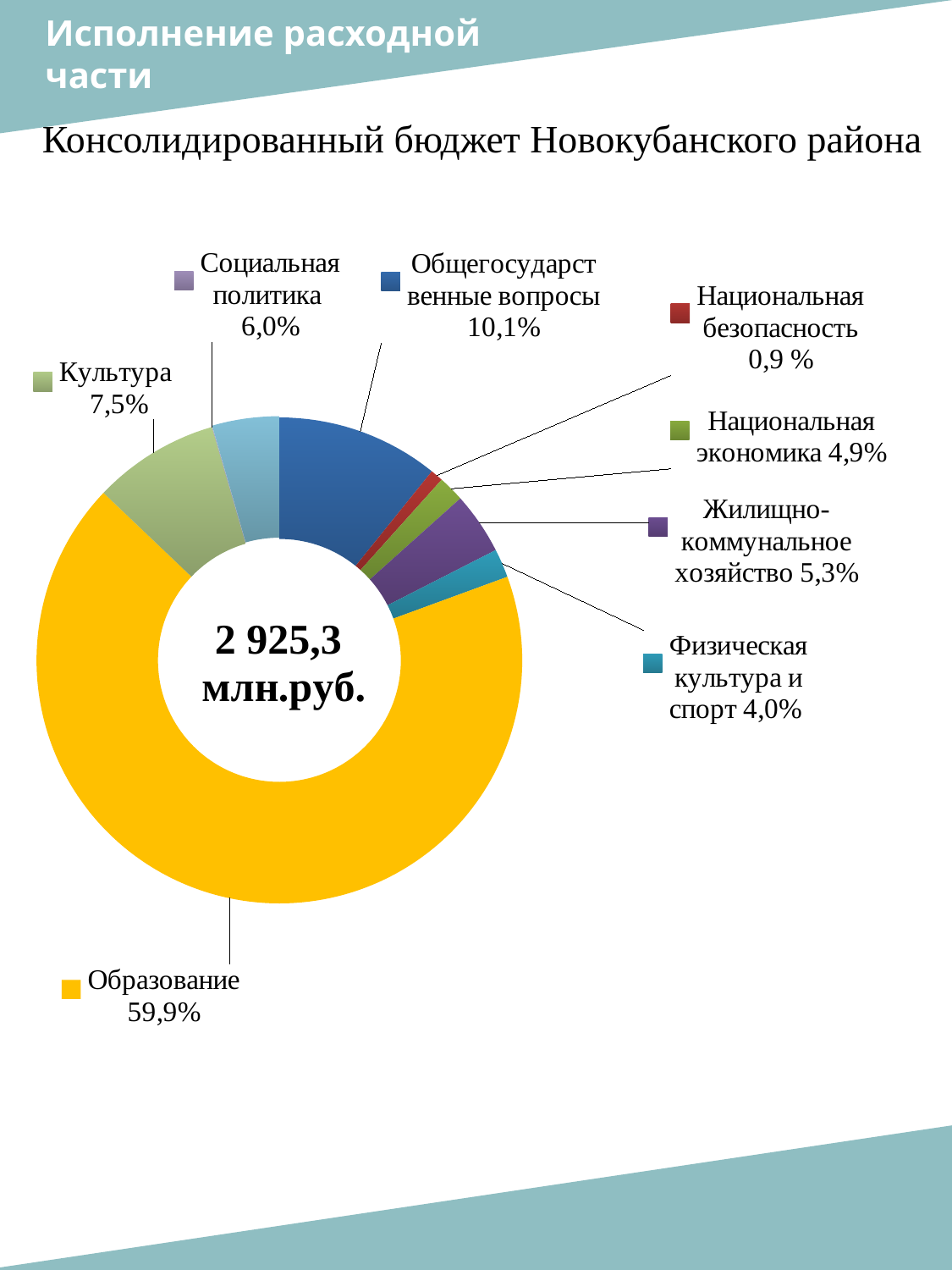
What is the difference in percentage points between Культура and Социальная политика? 1,5 Which has a larger share: Национальная экономика or Физическая культура и спорт? Национальная экономика Which category has the smallest share of the budget? Национальная безопасность What share is shown for Общегосударственные вопросы? 10,1% What share is shown for Жилищно-коммунальное хозяйство? 5,3% How many categories are shown in the chart? 8 What share of the consolidated budget goes to Образование? 59,9% What kind of chart is shown on the slide? Pie (doughnut) chart What is the title of the chart? Консолидированный бюджет Новокубанского района Which category has the largest share of the budget? Образование What share is shown for Национальная безопасность? 0,9 % What total amount is printed in the centre of the chart? 2 925,3 млн.руб.